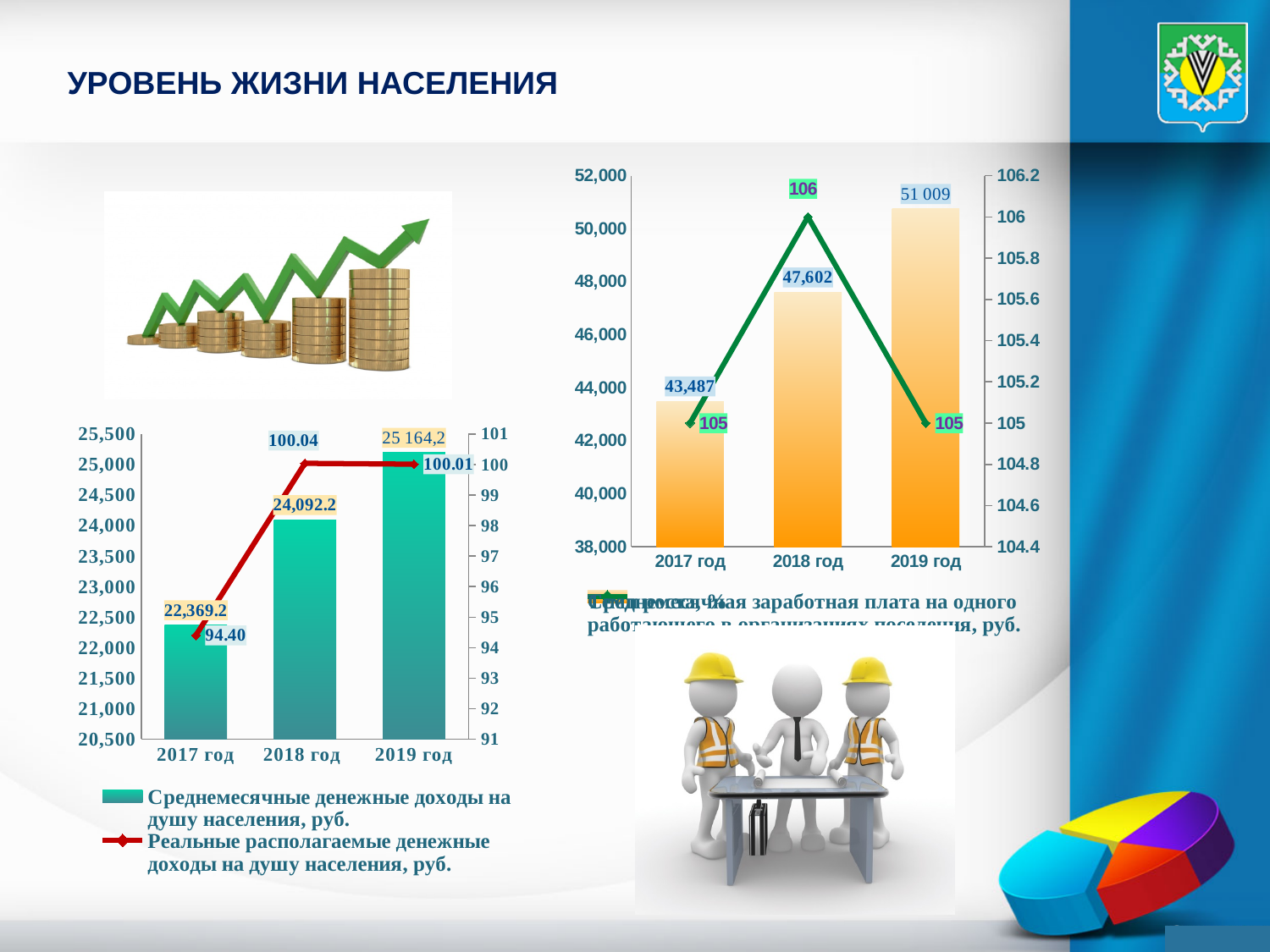
In the left chart, what is the difference between the bar values for 2018 год and 2017 год? 1,723.0 In the left chart, which year has the highest bar? 2019 год In the left chart, how many series does the legend list? 2 In the right chart, how many years are shown on the x axis? 3 In the right chart, which year has the lowest bar? 2017 год In the right chart, what is the value of the line point for 2018 год? 106 In the left chart, what is the value of the line point for 2017 год? 94.40 In the left chart, what is the value of the bar for 2017 год? 22,369.2 In the left chart, what is the value of the bar for 2018 год? 24,092.2 In the right chart, what is the value of the bar for 2018 год? 47,602 In the left chart, do the bar values rise or fall from 2017 год to 2019 год? rise In the right chart, what is the value of the bar for 2017 год? 43,487